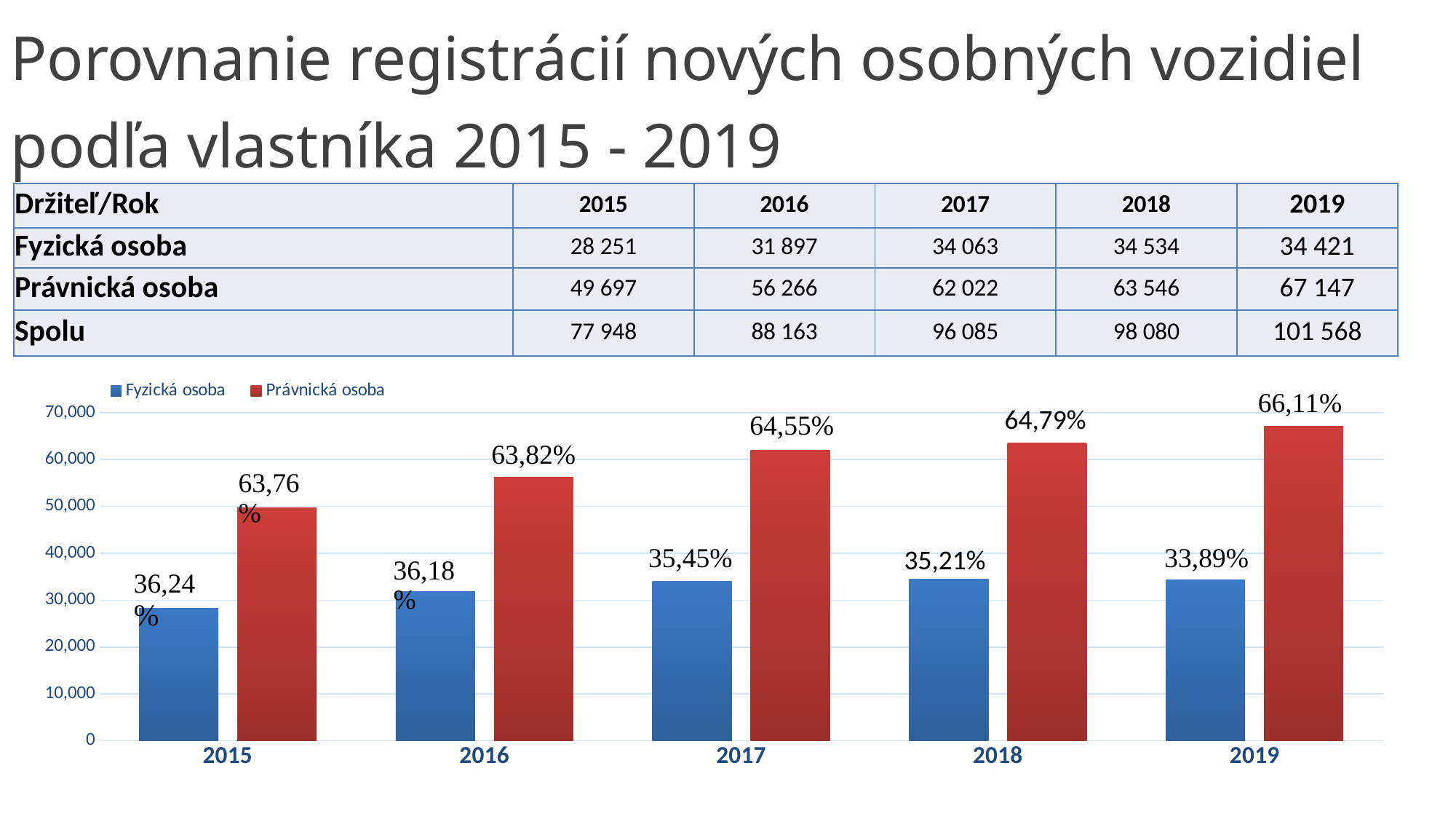
Do the Právnická osoba bars rise or fall from 2015 to 2019? rise In which year is the Právnická osoba bar the tallest? 2019 What data label is shown on the Právnická osoba bar for 2016? 63,82% How many years are shown on the x axis of the chart? 5 Is the Právnická osoba bar for 2015 greater or less than 40,000? greater In 2018, which bar is taller: Fyzická osoba or Právnická osoba? Právnická osoba Is the Fyzická osoba bar for 2015 greater or less than 40,000? less What kind of chart is shown on the slide? bar chart What is the difference between the data labels on the Právnická osoba and Fyzická osoba bars for 2019? 32,22% How many series does the chart legend list? 2 What data label is shown on the Fyzická osoba bar for 2017? 35,45% What data label is shown on the Právnická osoba bar for 2019? 66,11%